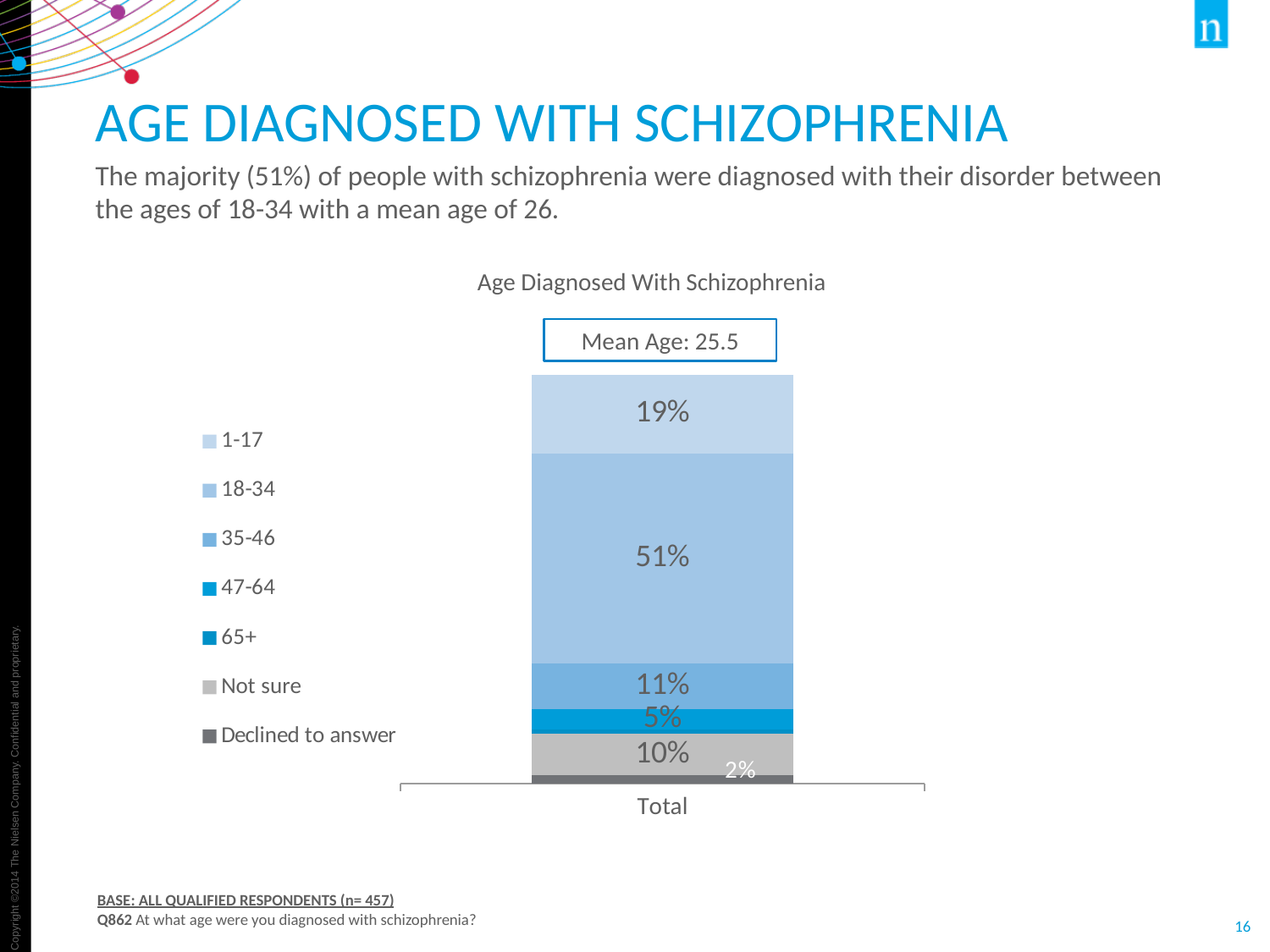
What percentage of respondents were diagnosed at ages 1-17? 19% How many series does the legend list? 7 What is the difference in percentage points between the 18-34 group and the 1-17 group? 32 percentage points What percentage of respondents were diagnosed at ages 47-64? 5% What percentage of respondents were diagnosed with schizophrenia between the ages of 18-34? 51% Which is larger, the share for 1-17 or the share for 35-46? 1-17 What type of chart is shown on the slide? Stacked bar chart What percentage of respondents answered 'Not sure'? 10% What is the value shown for the 35-46 age group? 11% What percentage of respondents declined to answer? 2% What mean age is shown in the box above the bar? 25.5 Which age group has the largest share of the stacked bar? 18-34